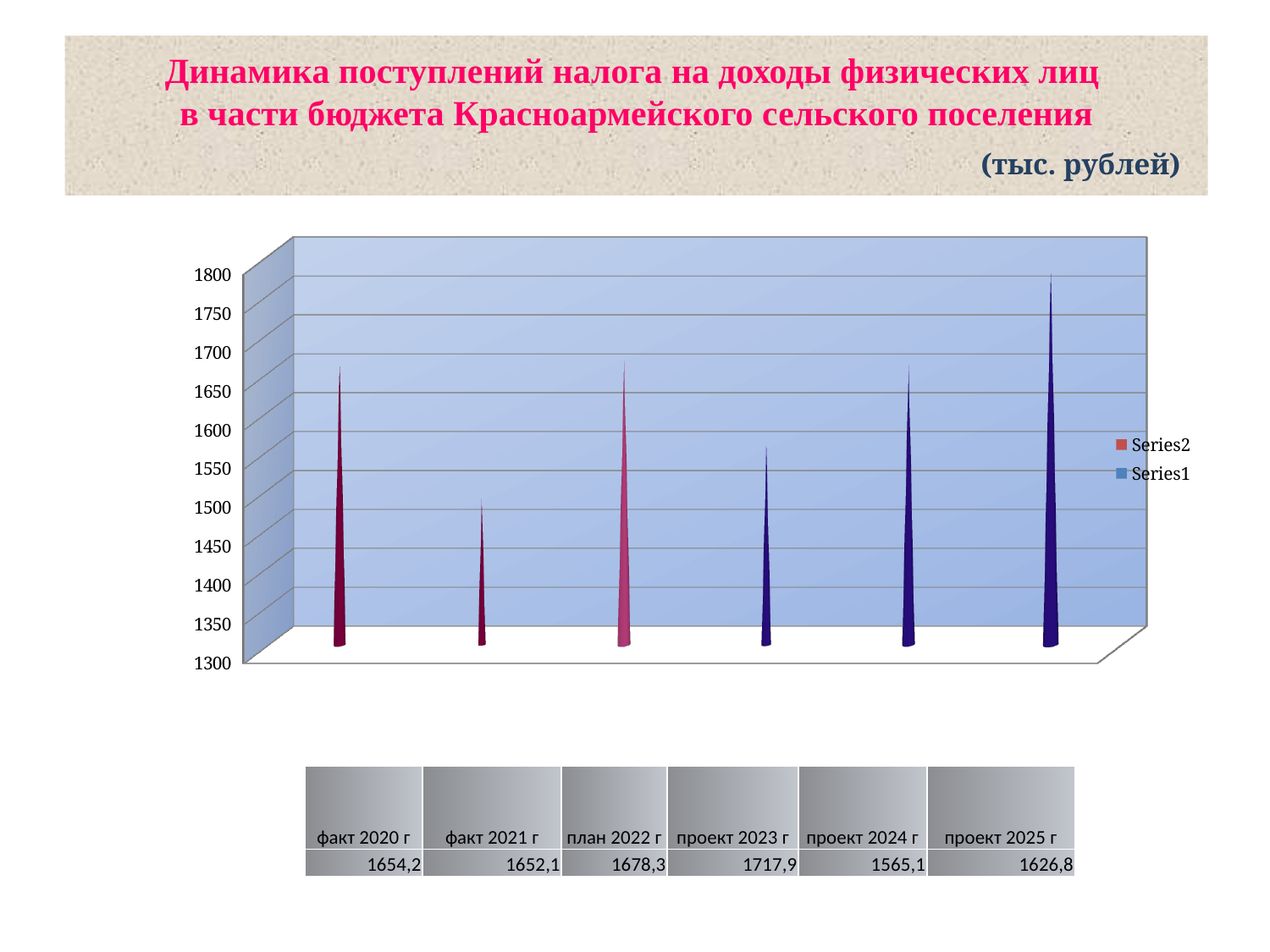
What is the difference between the values for проект 2023 г and проект 2024 г? 152,8 How many series does the legend list? 2 What is the difference between the values for план 2022 г and факт 2020 г? 24,1 How many categories are shown in the chart? 6 What is the value for проект 2024 г? 1565,1 What is the value for факт 2021 г? 1652,1 What is the value for проект 2025 г? 1626,8 In what units are the values on the slide given? тыс. рублей What is the value for план 2022 г? 1678,3 What kind of chart is shown on the slide? Bar chart What is the value for факт 2020 г? 1654,2 What is the value for проект 2023 г? 1717,9